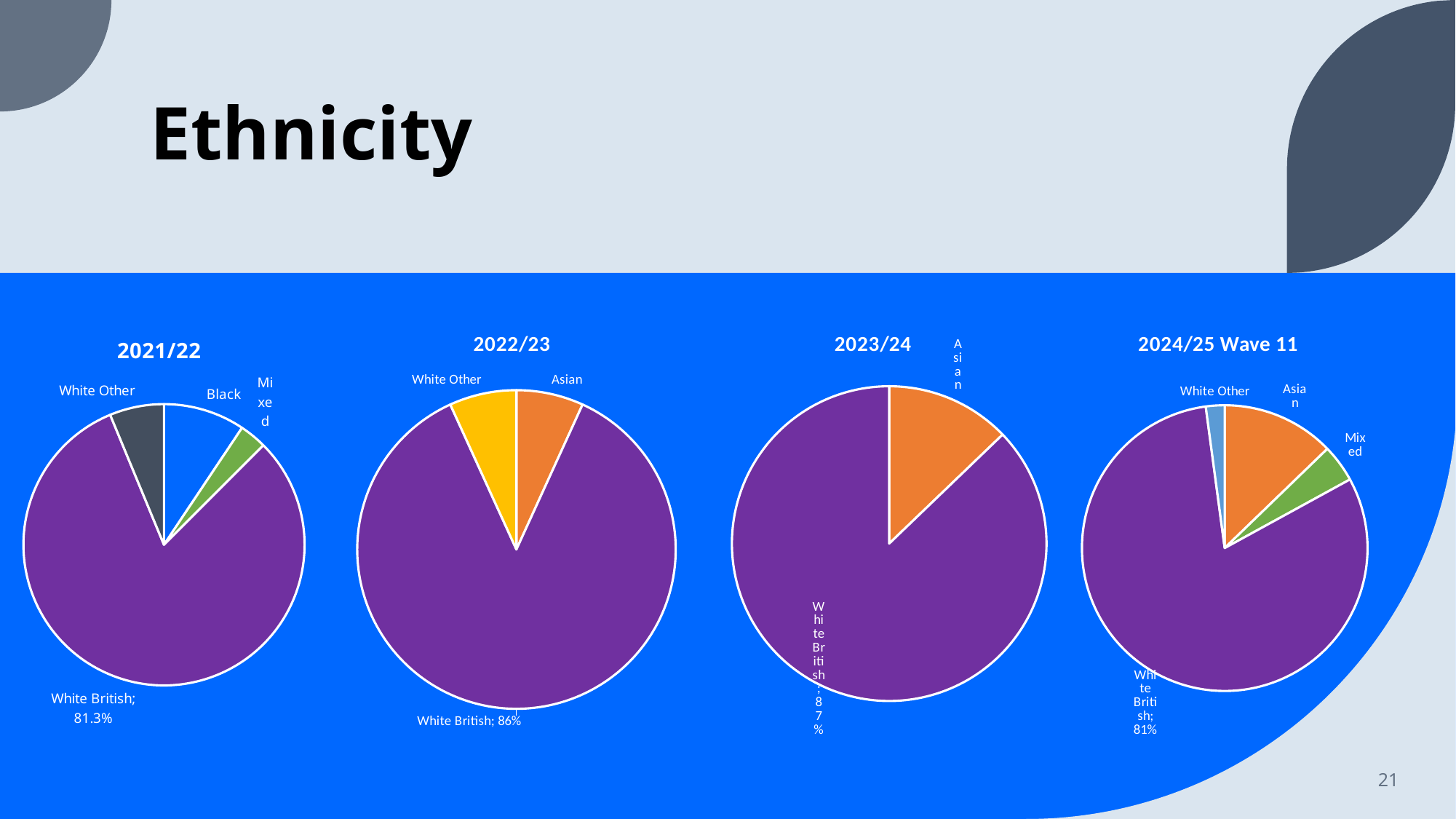
What is the difference between the White British share in the 2023/24 chart and in the 2022/23 chart? 1 percentage point In the 2022/23 pie chart, what share is labelled for White British? 86% How many categories are shown in the 2023/24 pie chart? 2 In the 2021/22 pie chart, what share is labelled for White British? 81.3% In the 2024/25 Wave 11 pie chart, what share is labelled for White British? 81% In the 2024/25 Wave 11 pie chart, which slice is larger, Asian or Mixed? Asian In the 2024/25 Wave 11 pie chart, which category has the smallest slice? White Other In the 2024/25 Wave 11 pie chart, which category has the largest slice? White British How many categories are shown in the 2022/23 pie chart? 3 What type of chart is used for the 2021/22 data? Pie chart Is the White British share larger in the 2022/23 chart or the 2023/24 chart? 2023/24 In the 2023/24 pie chart, what share is labelled for White British? 87%